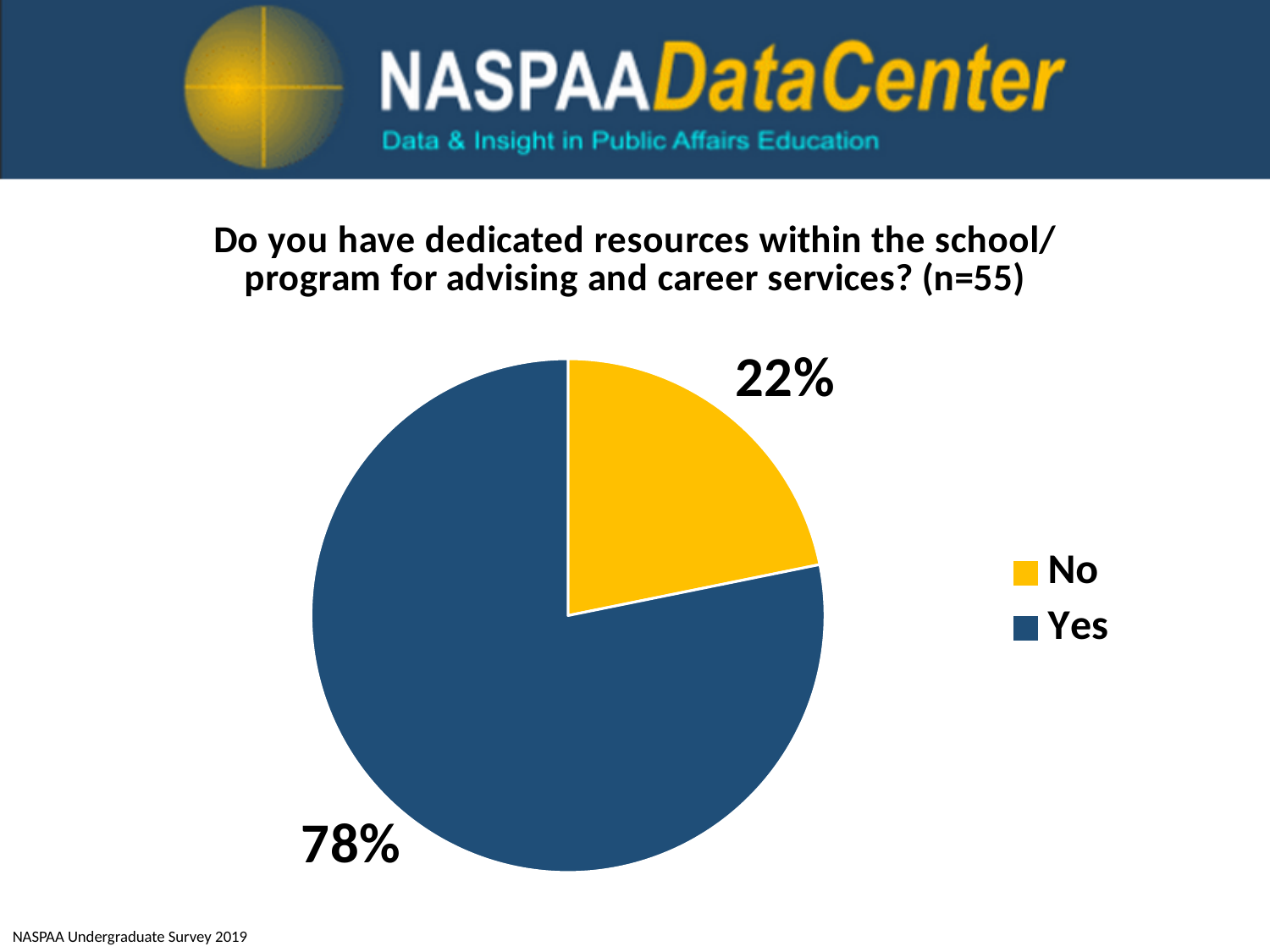
What colour is the "Yes" slice? blue How many entries does the legend list? 2 What kind of chart is shown on the slide? pie chart Which is larger, the share for "Yes" or the share for "No"? Yes How many slices does the pie chart have? 2 How many respondents (n) does the chart title report? 55 What is the difference in percentage points between the "Yes" and "No" shares? 56 Which response has the smallest share of the pie? No What percentage of respondents answered "No"? 22% Which response has the largest share of the pie? Yes What share of the pie does the "No" slice represent? 22% What percentage of respondents answered "Yes"? 78%